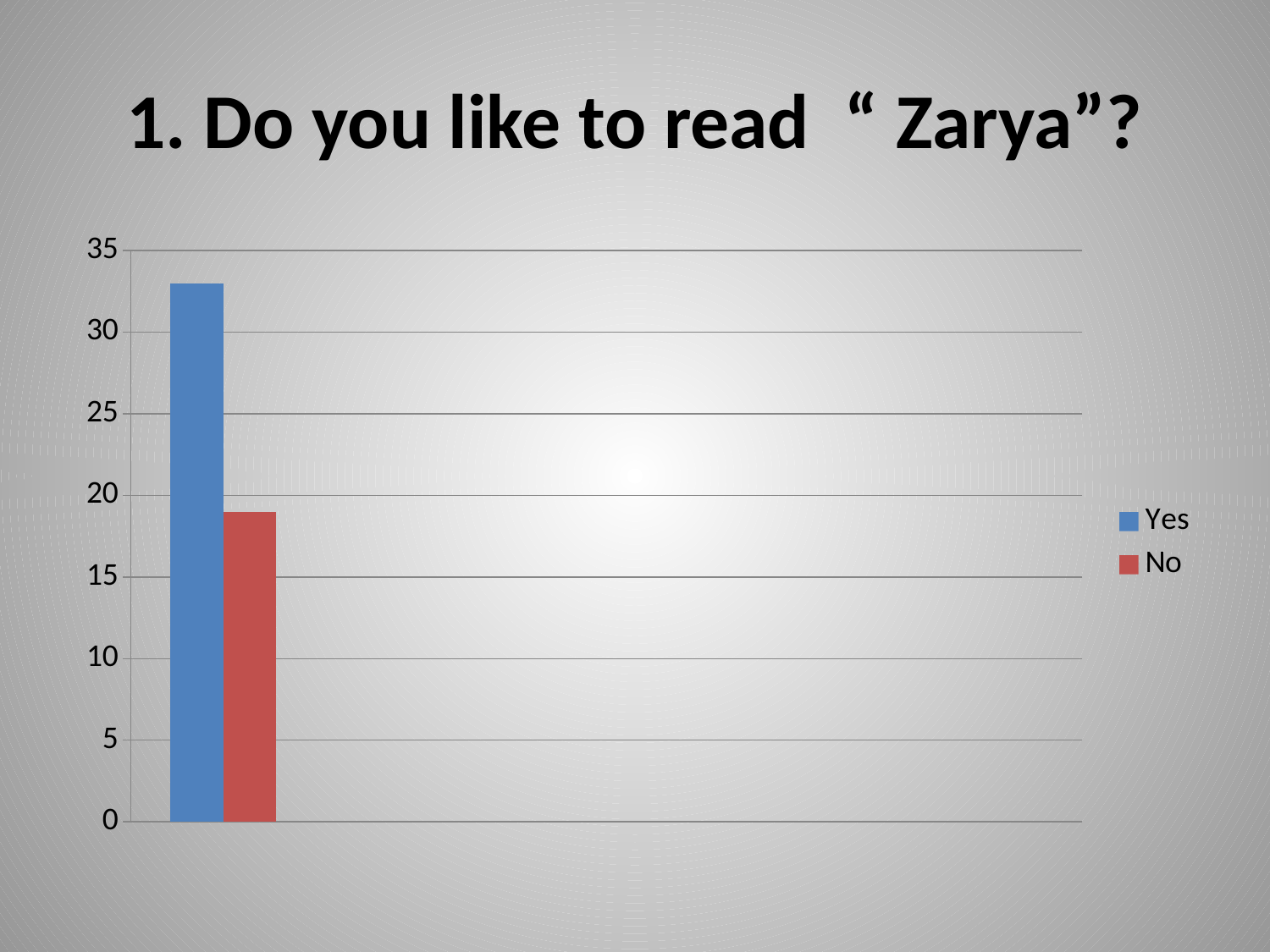
What kind of chart is shown on the slide? bar chart Which is larger, the value for Yes or the value for No? Yes What colour is the bar for the No series? red Is the value for No greater or less than 15? greater What is the title of the slide above the chart? 1. Do you like to read "Zarya"? How many series does the legend list? 2 Is the value for Yes greater or less than 30? greater Which series has the lowest bar, Yes or No? No Is the value for No greater or less than 25? less How many bars are plotted in the chart? 2 Which series has the highest bar, Yes or No? Yes